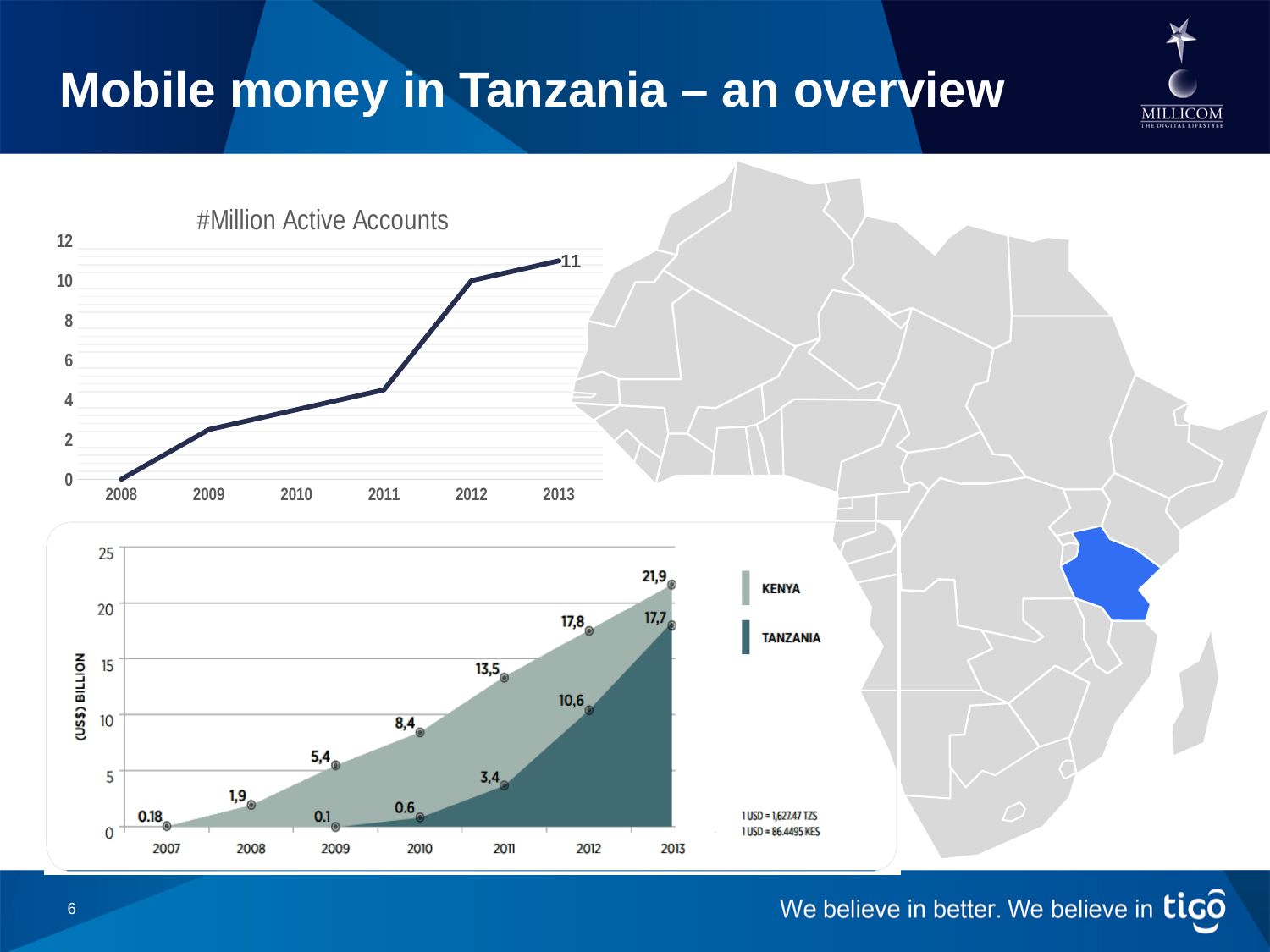
In the '#Million Active Accounts' chart, is the value for 2012 greater or less than 8? greater In the bottom (US$ billion) chart, how many series does the legend list? 2 In the '#Million Active Accounts' chart, do the values rise or fall from 2008 to 2013? rise In the bottom (US$ billion) chart, what is the value for Kenya in 2013? 21,9 In the '#Million Active Accounts' chart, what value is labelled for 2013? 11 In the bottom (US$ billion) chart, what is the value for Kenya in 2007? 0.18 In the '#Million Active Accounts' chart, what type of chart is used? line chart In the '#Million Active Accounts' chart, how many years are shown on the x axis? 6 In the bottom (US$ billion) chart, which is larger in 2011, Kenya or Tanzania? Kenya In the bottom (US$ billion) chart, what is the value for Tanzania in 2012? 10,6 In the bottom (US$ billion) chart, what is the difference between Kenya's and Tanzania's values in 2012? 7,2 In the '#Million Active Accounts' chart, is the value for 2009 greater or less than 4? less